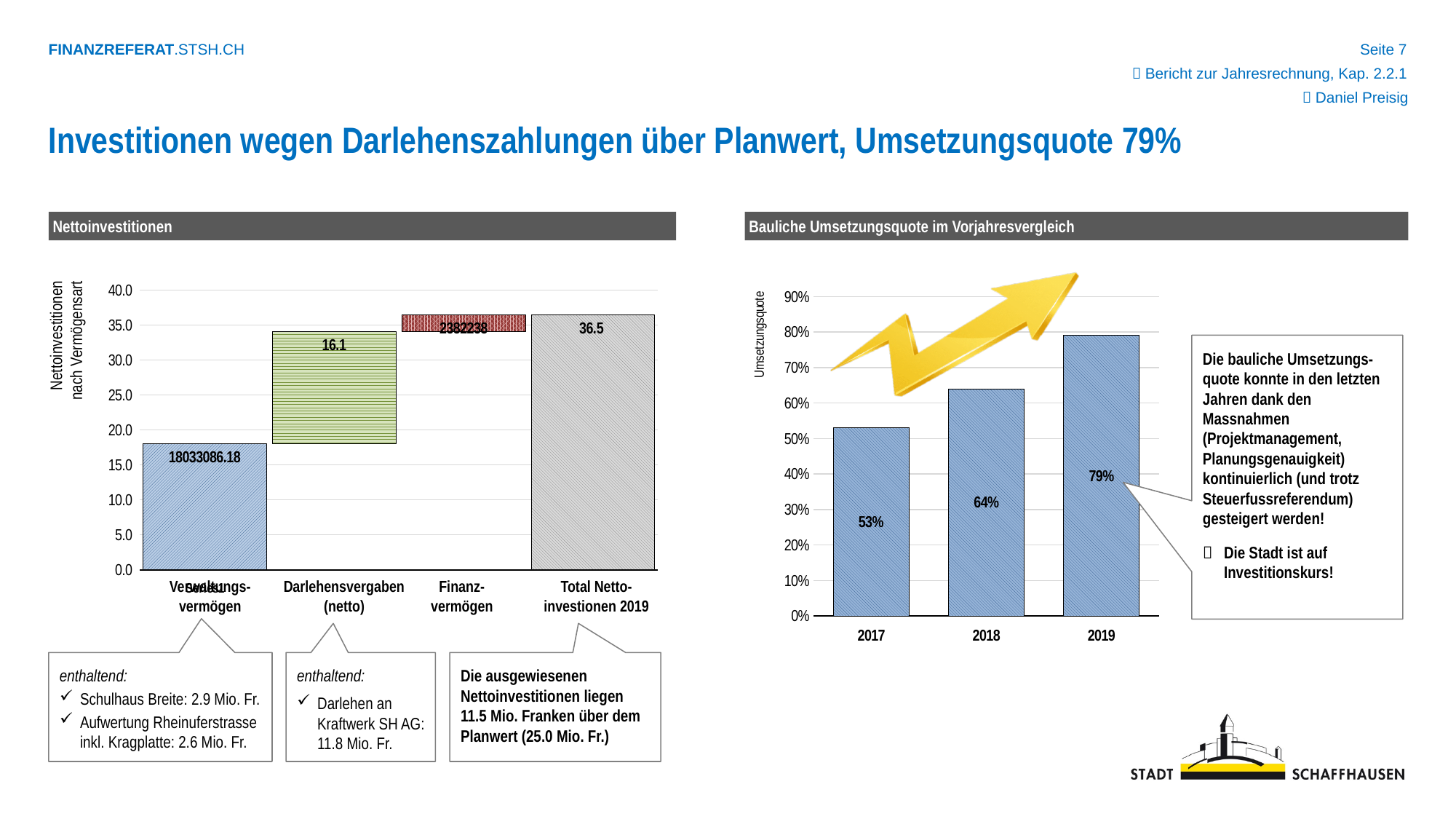
On the 'Bauliche Umsetzungsquote im Vorjahresvergleich' chart, by how many percentage points did the value rise from 2017 to 2019? 26 percentage points On the 'Bauliche Umsetzungsquote im Vorjahresvergleich' chart, which year has the highest value? 2019 What kind of chart is the 'Bauliche Umsetzungsquote im Vorjahresvergleich' chart? bar chart On the 'Nettoinvestitionen' chart, what is the value for 'Total Netto-investitionen 2019'? 36.5 On the 'Nettoinvestitionen' chart, what is the value labelled on the 'Darlehensvergaben (netto)' bar? 16.1 On the 'Bauliche Umsetzungsquote im Vorjahresvergleich' chart, what is the value for 2017? 53% On the 'Bauliche Umsetzungsquote im Vorjahresvergleich' chart, do the values rise or fall from 2017 to 2019? rise On the 'Bauliche Umsetzungsquote im Vorjahresvergleich' chart, which year has the lowest value? 2017 On the 'Nettoinvestitionen' chart, is the value for 'Total Netto-investionen 2019' greater or less than 35.0? greater On the 'Bauliche Umsetzungsquote im Vorjahresvergleich' chart, what is the value for 2019? 79% On the 'Bauliche Umsetzungsquote im Vorjahresvergleich' chart, what is the value for 2018? 64% On the 'Bauliche Umsetzungsquote im Vorjahresvergleich' chart, how many years are shown? 3